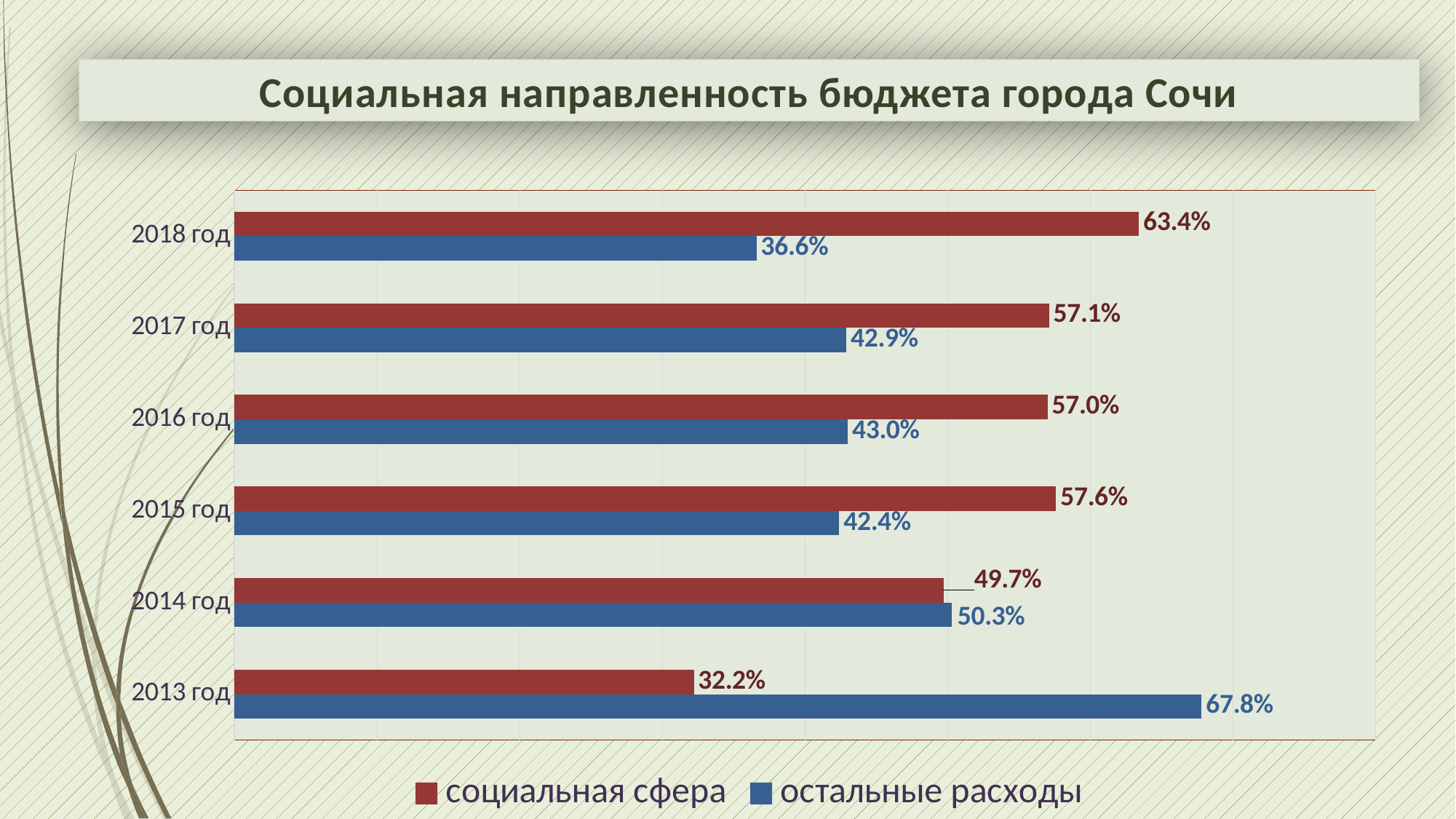
How many years are shown on the chart? 6 In which year is the value for социальная сфера the highest? 2018 год How many series does the legend list? 2 What type of chart is shown on the slide? bar chart What is the value for остальные расходы in 2015 год? 42.4% In 2014 год, which is larger: социальная сфера or остальные расходы? остальные расходы What is the value for остальные расходы in 2013 год? 67.8% In which year is the value for социальная сфера the lowest? 2013 год What is the value for социальная сфера in 2018 год? 63.4% What is the difference between социальная сфера and остальные расходы in 2018 год? 26.8% Does the value for социальная сфера generally rise or fall from 2013 год to 2018 год? rise What is the title of the slide? Социальная направленность бюджета города Сочи